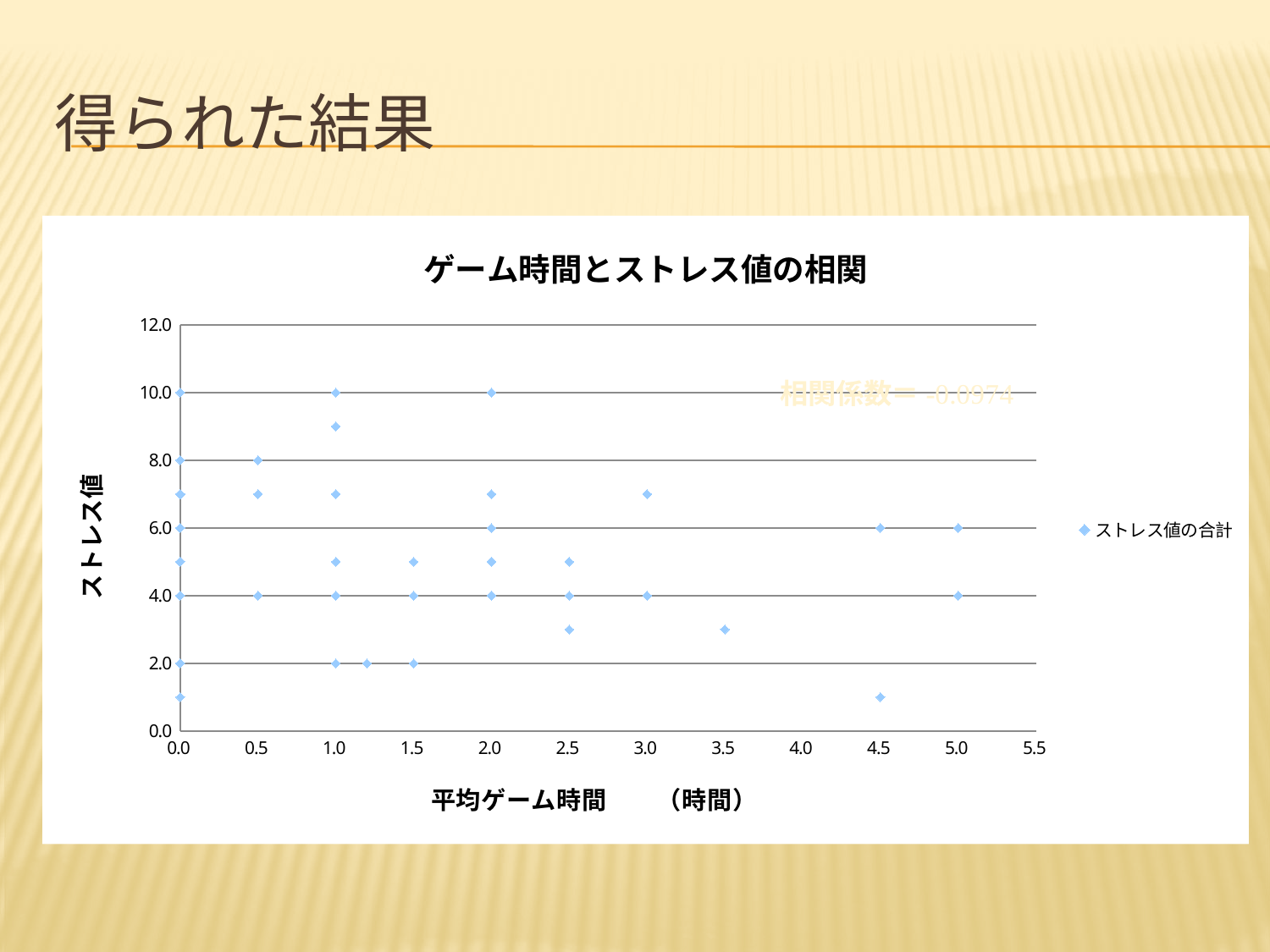
How many points are plotted at an average game time of 4.5 hours? 2 How many series does the legend list? 1 How many points are plotted at an average game time of 5.0 hours? 2 What is the highest stress value (ストレス値) plotted on the chart? 10.0 What kind of chart is shown on the slide? scatter chart What is the label of the series in the legend? ストレス値の合計 What is the maximum value shown on the vertical axis? 12.0 What is the largest average game time (平均ゲーム時間) at which a point is plotted? 5.0 What is the title of the chart? ゲーム時間とストレス値の相関 Is the stress value of the lower point at 4.5 hours greater or less than 2.0? less